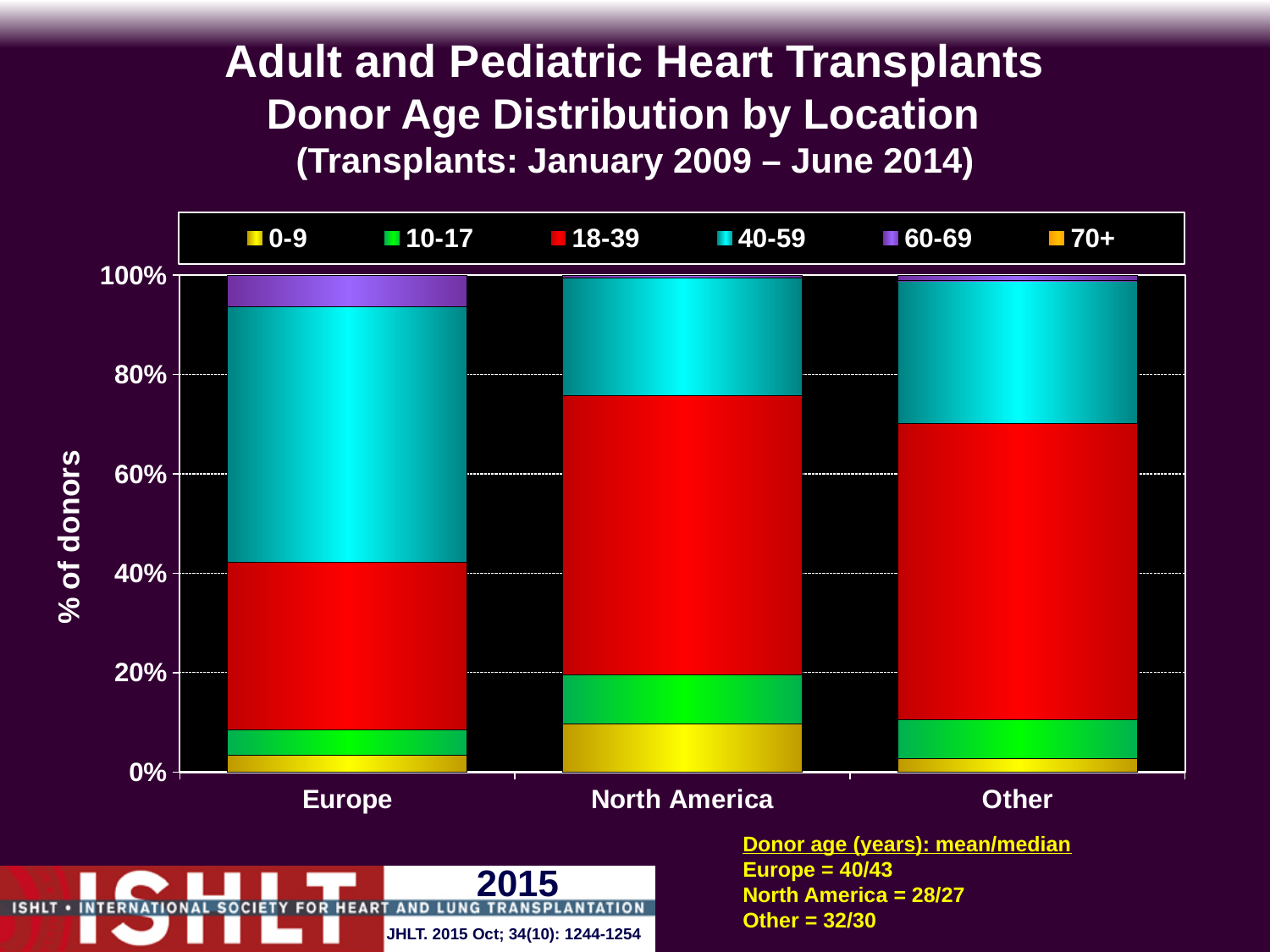
Which location has the largest share of donors aged 40-59? Europe How many donor age groups does the legend list? 6 Which location has the largest share of donors aged 0-9? North America What kind of chart is shown on the slide? Stacked bar chart Which location has the largest share of donors aged 60-69? Europe Is the share of donors aged 18-39 larger for Europe or for North America? North America Is the share of donors aged 40-59 larger for Europe or for North America? Europe How many locations are shown on the x axis of the chart? 3 What is the label of the y axis? % of donors According to the text below the chart, what is the mean/median donor age for North America? 28/27 Is the share of donors aged 0-9 in North America greater or less than 20%? less Is the share of donors aged 40-59 in Europe greater or less than 40%? greater